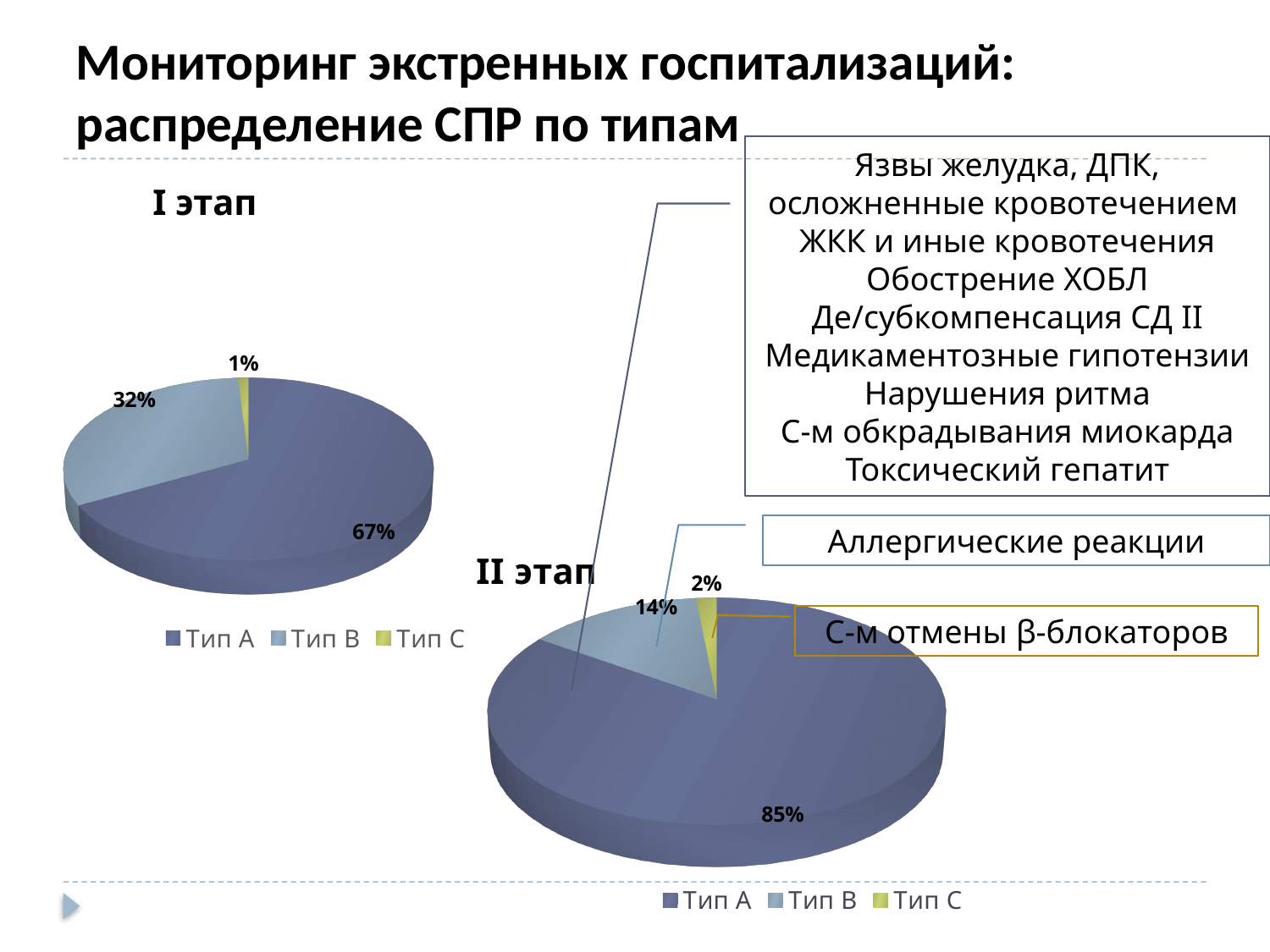
In the 'I этап' chart, what is the share for Тип C? 1% In the 'II этап' chart, what is the share for Тип B? 14% How many entries does the legend of the 'I этап' chart list? 3 In the 'II этап' chart, what is the share for Тип A? 85% In the 'I этап' chart, what is the share for Тип B? 32% In the 'I этап' chart, what is the difference between the shares of Тип A and Тип B? 35% What kind of chart is the 'II этап' chart? Pie chart In the 'II этап' chart, which type has the largest slice? Тип A In the 'I этап' chart, what is the share for Тип A? 67% In the 'I этап' chart, which type has the smallest slice? Тип C In the 'II этап' chart, what is the share for Тип C? 2% Which is larger: Тип B in the 'I этап' chart or Тип B in the 'II этап' chart? Тип B in the 'I этап' chart